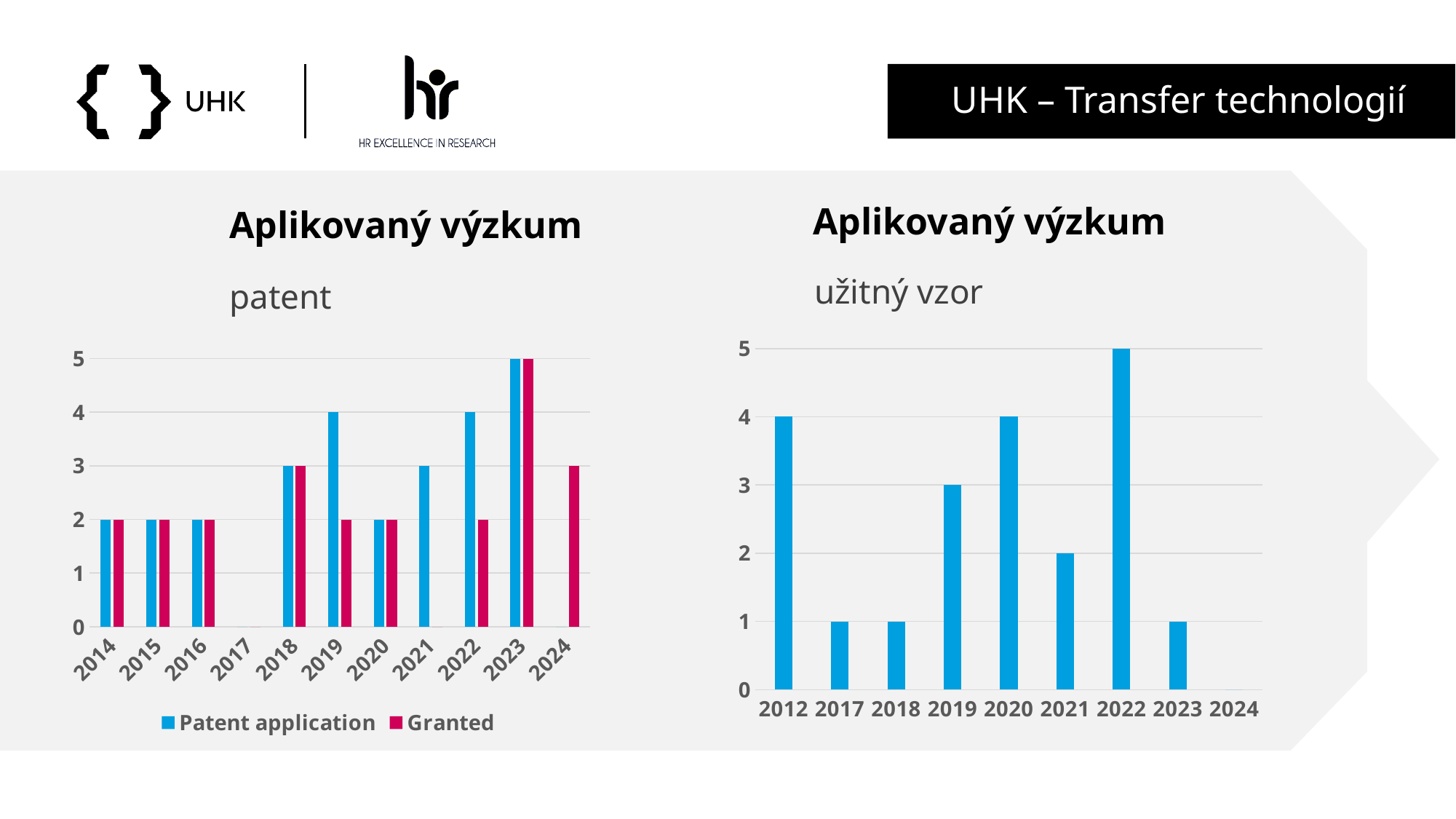
In the left chart (patent), what is the difference between Patent application and Granted in 2019? 2 In the left chart (patent), how many series does the legend list? 2 In the left chart (patent), what colour are the Granted bars? Magenta (pinkish red) In the right chart (užitný vzor), what is the value for 2022? 5 In the left chart (patent), which is larger in 2022: Patent application or Granted? Patent application In the left chart (patent), what is the value of Patent application for 2023? 5 In the right chart (užitný vzor), how many year categories are shown on the x axis? 9 What kind of chart is the right chart (užitný vzor)? Bar chart In the left chart (patent), which year has the highest Patent application value? 2023 In the right chart (užitný vzor), what is the value for 2021? 2 In the left chart (patent), what is the value of Granted for 2024? 3 In the right chart (užitný vzor), which year has the highest value? 2022